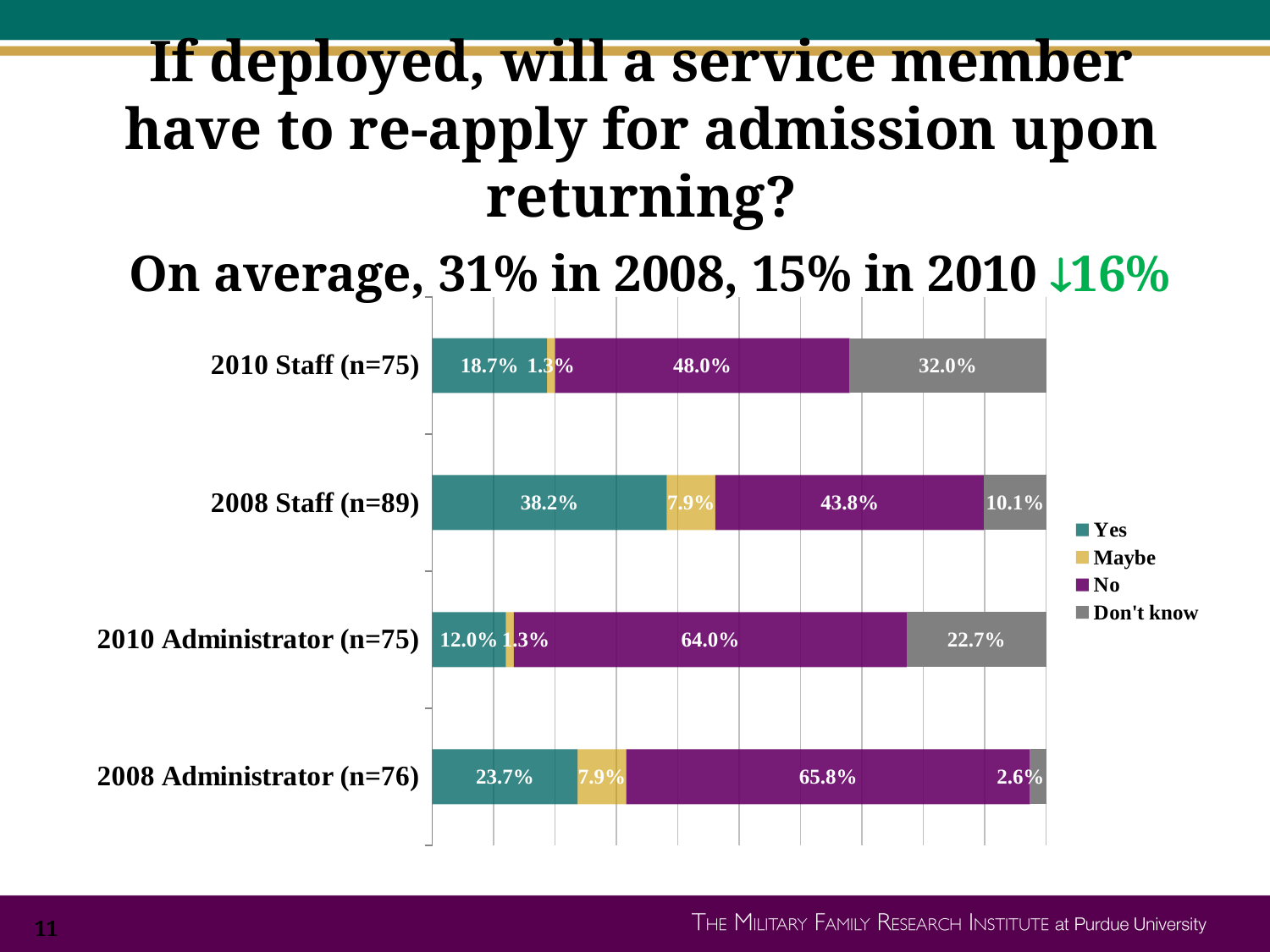
What kind of chart is shown on the slide? Stacked bar chart Which is larger: the "No" percentage for 2010 Administrator (n=75) or for 2010 Staff (n=75)? 2010 Administrator (n=75) What percentage of 2010 Staff (n=75) answered "No"? 48.0% What is the "Don't know" value for 2010 Administrator (n=75)? 22.7% What is the difference between the "Yes" percentages for 2008 Staff (n=89) and 2010 Staff (n=75)? 19.5% Which legend entry is shown in purple? No How many groups (bars) are shown in the chart? 4 Which group has the highest "Yes" percentage? 2008 Staff (n=89) How many series does the legend list? 4 What percentage of 2008 Administrator (n=76) answered "Yes"? 23.7% Which group has the lowest "Don't know" percentage? 2008 Administrator (n=76) What is the "Maybe" value for 2008 Staff (n=89)? 7.9%